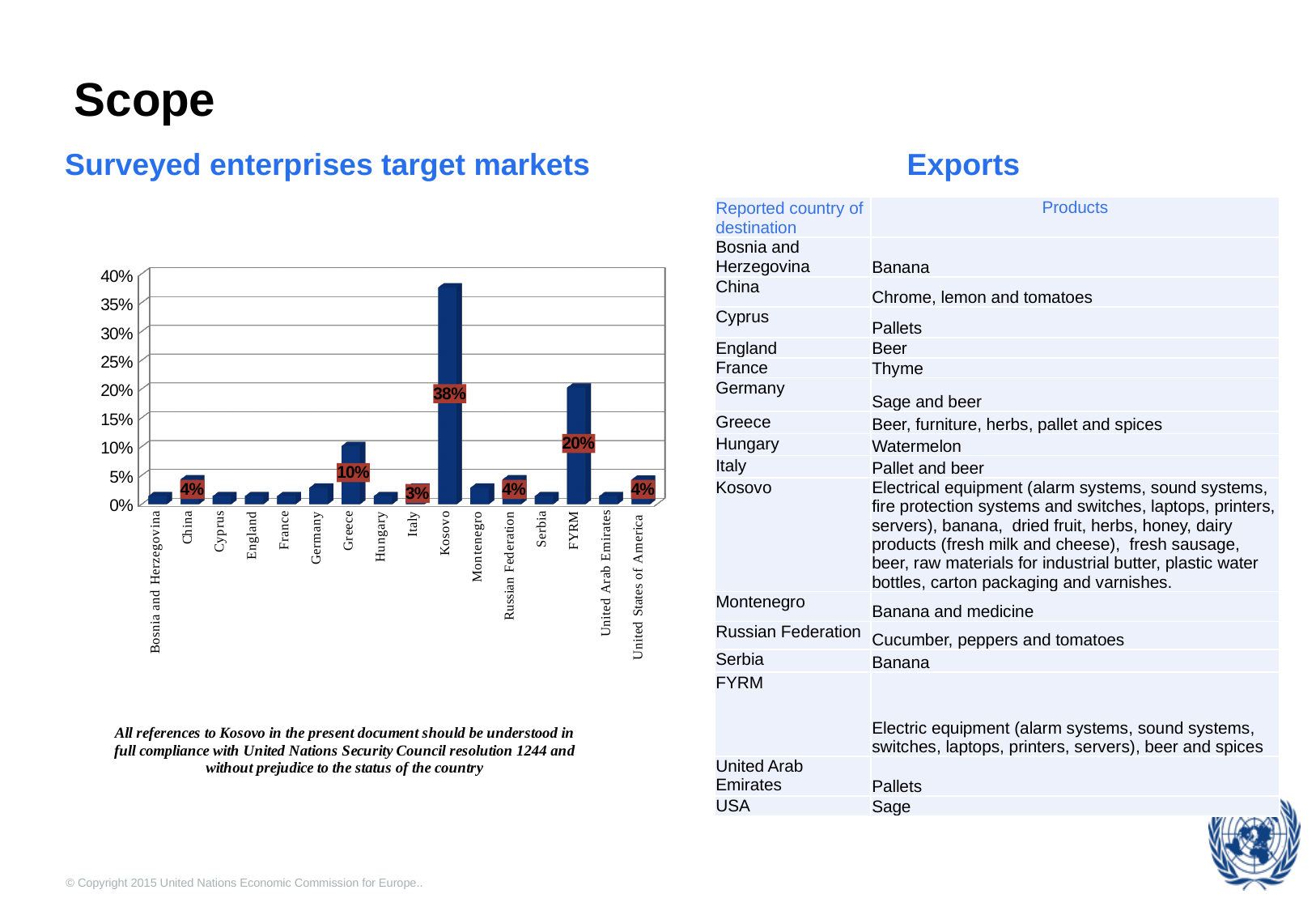
What value is shown for Italy? 3% Is the value for Kosovo greater or less than 35%? greater How many target market categories are shown on the x axis of the chart? 16 What percentage of surveyed enterprises target Kosovo? 38% What is the value shown for FYRM in the target markets chart? 20% What is the title of the chart on the left of the slide? Surveyed enterprises target markets What percentage is labelled for Greece? 10% Which target market has the highest percentage? Kosovo What value is labelled for the Russian Federation? 4% Which has a higher value, Greece or Italy? Greece What is the difference in percentage points between Kosovo and FYRM? 18 percentage points What kind of chart is used to show the surveyed enterprises' target markets? Bar chart